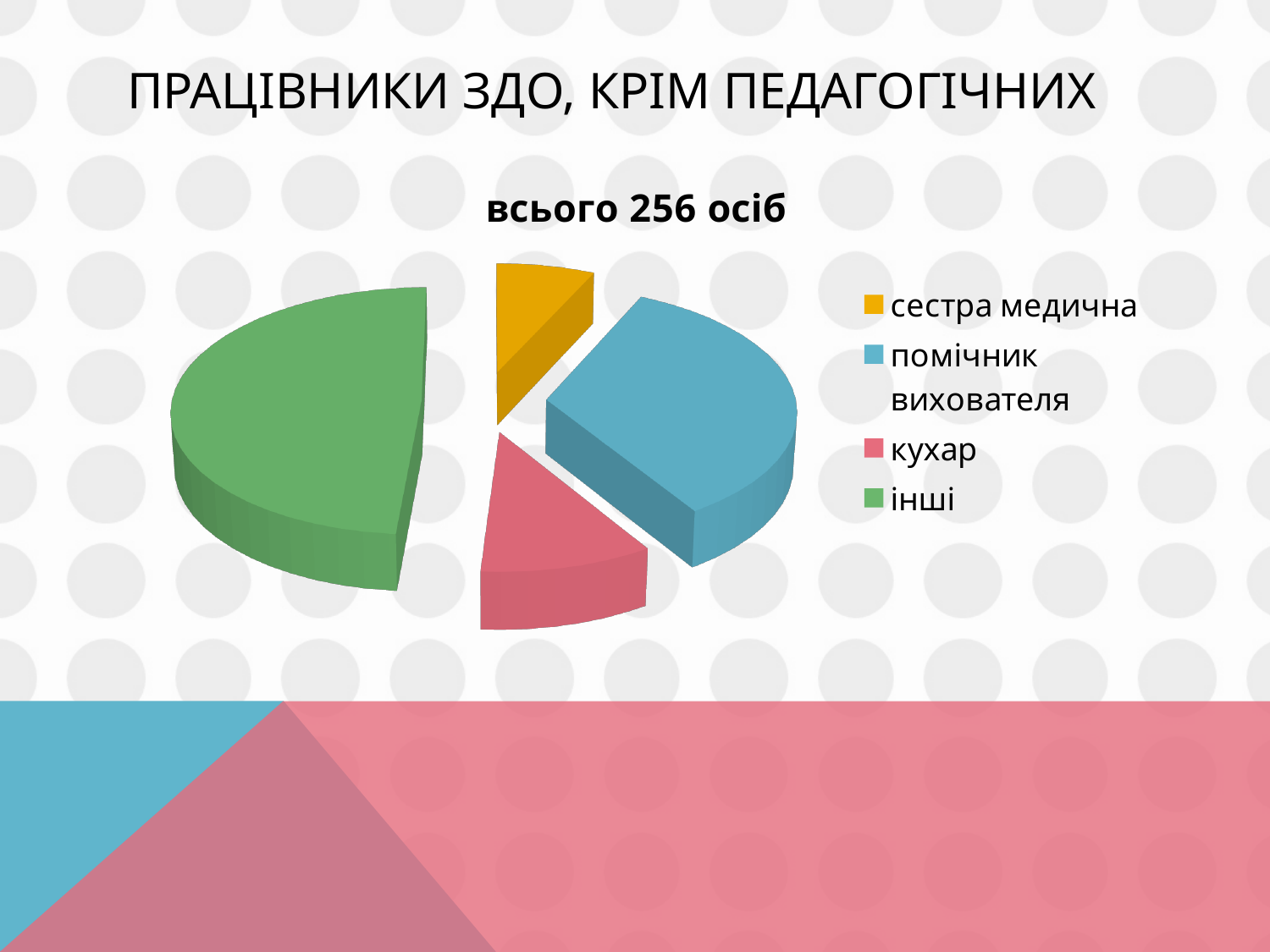
Which slice is larger, інші or помічник вихователя? інші Which slice is larger, помічник вихователя or кухар? помічник вихователя What kind of chart is shown on the slide? pie chart How many slices does the pie chart have? 4 Which category has the smallest slice of the pie? сестра медична Which slice is larger, кухар or сестра медична? кухар What is the title of the chart? всього 256 осіб How many entries does the chart legend list? 4 Which colour represents кухар in the pie chart? red Which category has the largest slice of the pie? інші